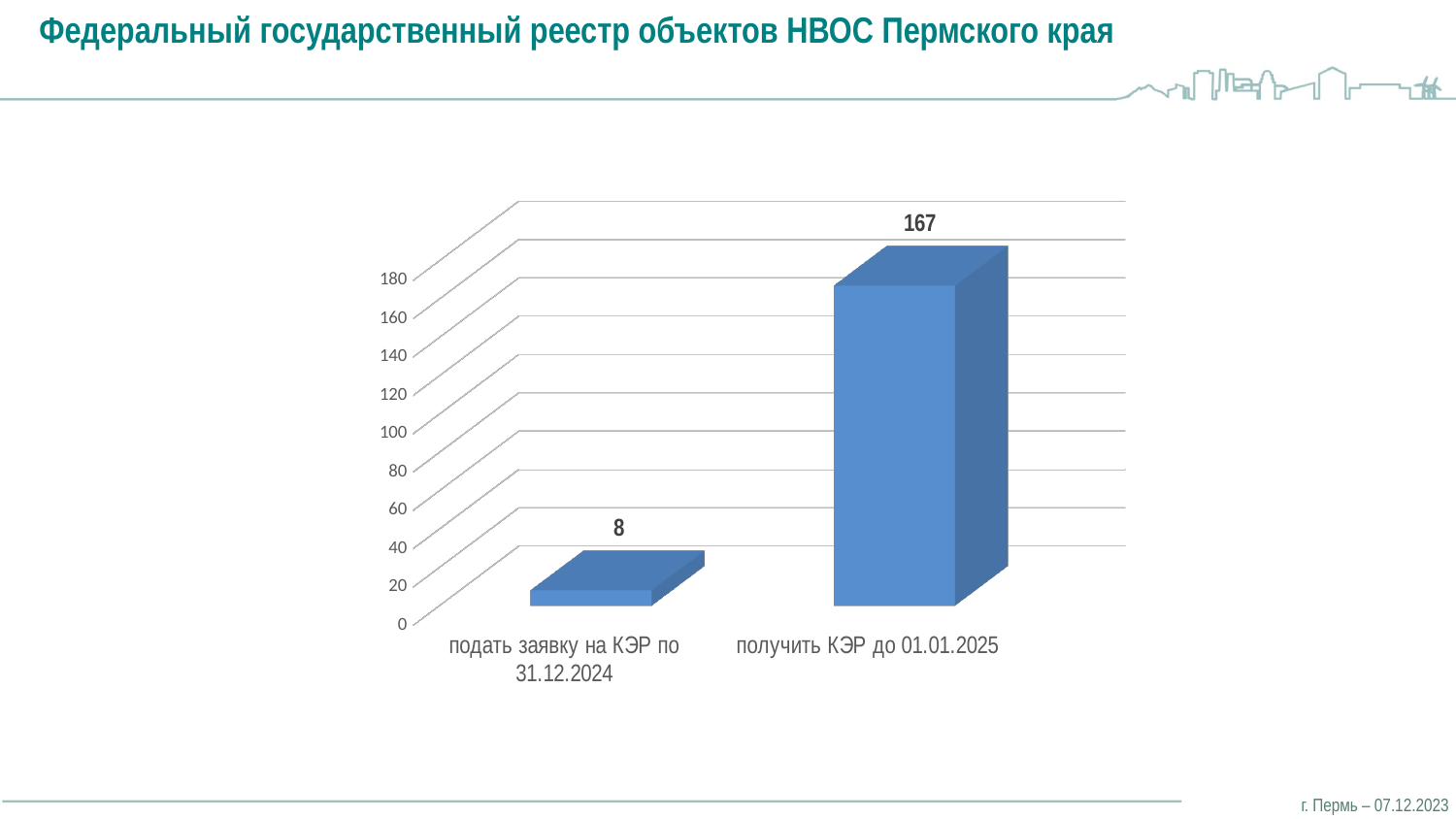
Which is larger: the value for "подать заявку на КЭР по 31.12.2024" or the value for "получить КЭР до 01.01.2025"? получить КЭР до 01.01.2025 What is the maximum value shown on the vertical axis? 180 What is the difference between the values for "получить КЭР до 01.01.2025" and "подать заявку на КЭР по 31.12.2024"? 159 What is the value for "подать заявку на КЭР по 31.12.2024"? 8 Which category has the highest value? получить КЭР до 01.01.2025 What kind of chart is shown on the slide? bar chart Which category has the lowest value? подать заявку на КЭР по 31.12.2024 Is the value for "подать заявку на КЭР по 31.12.2024" greater or less than 20? less How many categories are shown in the chart? 2 What is the total of the two values shown in the chart? 175 Is the value for "получить КЭР до 01.01.2025" greater or less than 160? greater What is the value for "получить КЭР до 01.01.2025"? 167